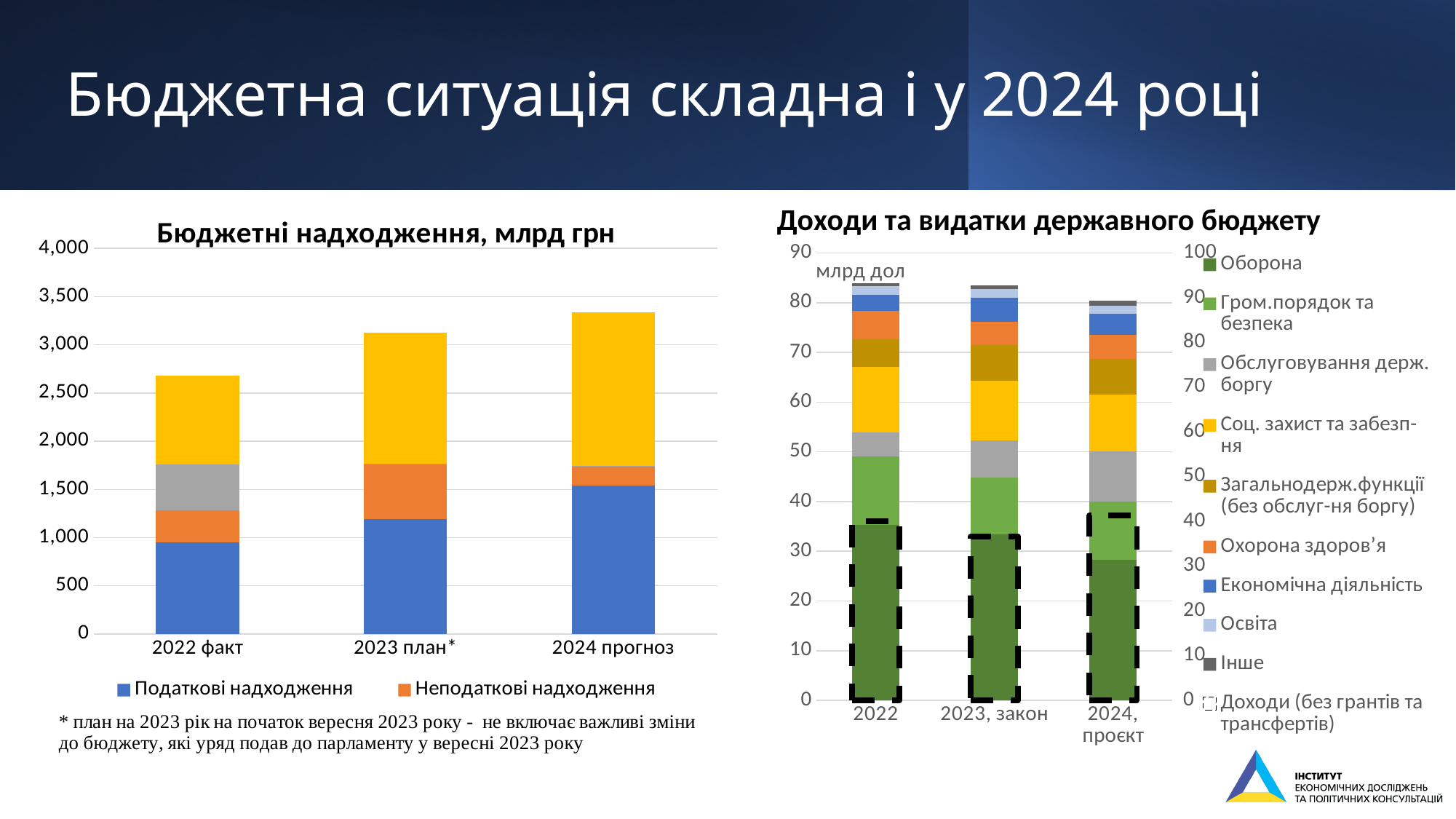
In the right chart "Доходи та видатки державного бюджету", is the value of Оборона for 2024, проєкт greater or less than 30? less How many categories are shown on the x axis of the left chart "Бюджетні надходження, млрд грн"? 3 In the right chart "Доходи та видатки державного бюджету", which is larger: Оборона for 2022 or for 2024, проєкт? 2022 In the left chart "Бюджетні надходження, млрд грн", is the total height of the 2024 прогноз bar greater or less than 3,500? less What is the title of the right chart? Доходи та видатки державного бюджету In the left chart "Бюджетні надходження, млрд грн", do the total bar heights rise or fall from 2022 факт to 2024 прогноз? rise In the left chart "Бюджетні надходження, млрд грн", which is larger: Податкові надходження for 2022 факт or for 2024 прогноз? 2024 прогноз How many categories are shown on the x axis of the right chart "Доходи та видатки державного бюджету"? 3 How many entries does the legend of the right chart "Доходи та видатки державного бюджету" list? 10 What kind of chart is the left chart titled "Бюджетні надходження, млрд грн"? stacked bar chart